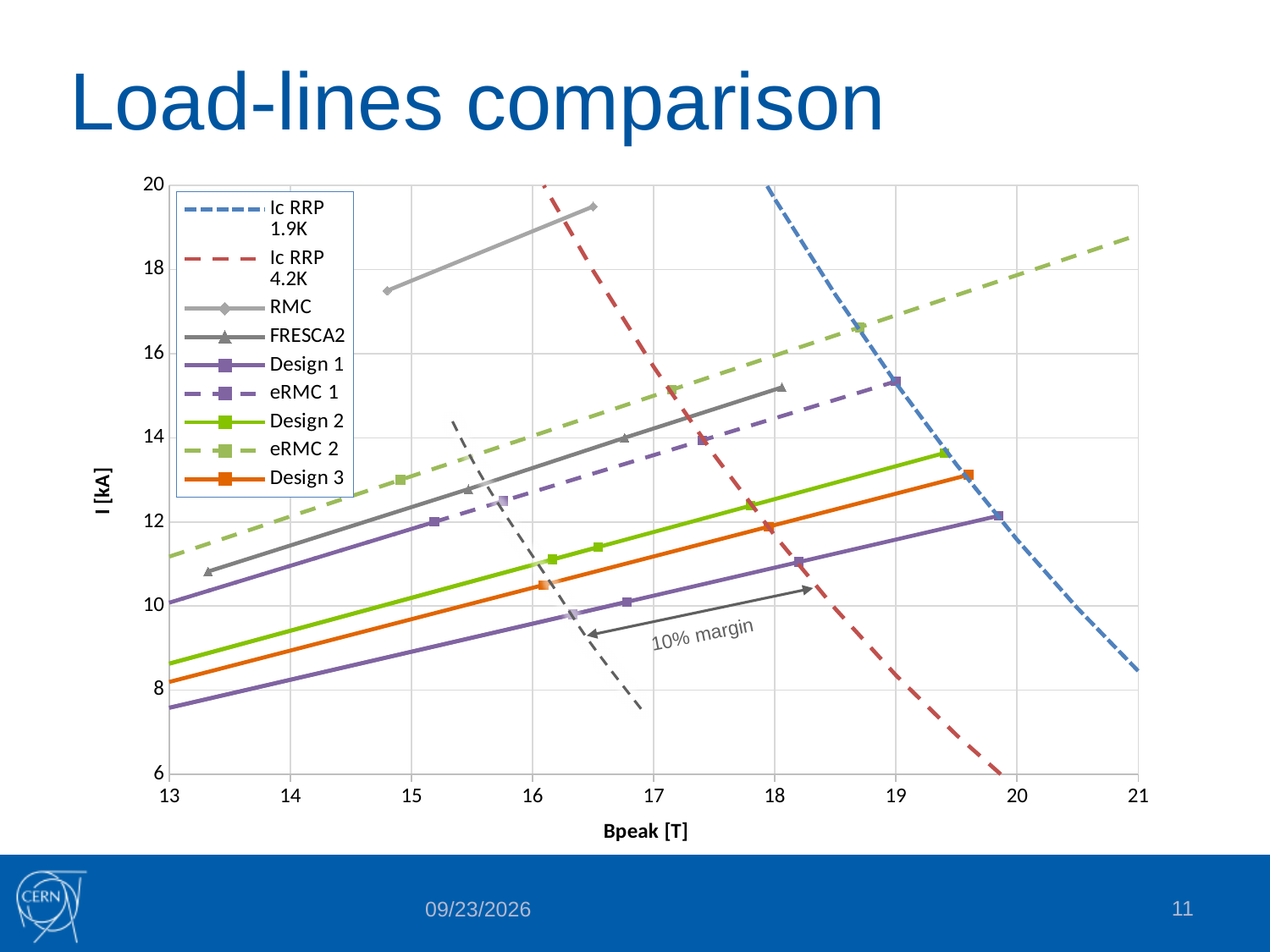
What is the title of the y axis of the chart? I [kA] At Bpeak = 17 T, which line has the higher current: eRMC 2 or eRMC 1? eRMC 2 At Bpeak = 17 T, which line has the higher current: Design 2 or Design 1? Design 2 What kind of chart is shown on the slide? line chart Is the value of the Design 1 line at Bpeak = 13 T greater or less than 8 kA? less Does the Ic RRP 1.9K curve rise or fall as Bpeak increases? fall What is the title of the x axis of the chart? Bpeak [T] How many series does the chart legend list? 9 Is the value of the FRESCA2 line at its left end (around Bpeak = 13.3 T) greater or less than 10 kA? greater Is the value of the eRMC 2 line at Bpeak = 21 T greater or less than 18 kA? greater Does the Design 1 line rise or fall as Bpeak increases? rise